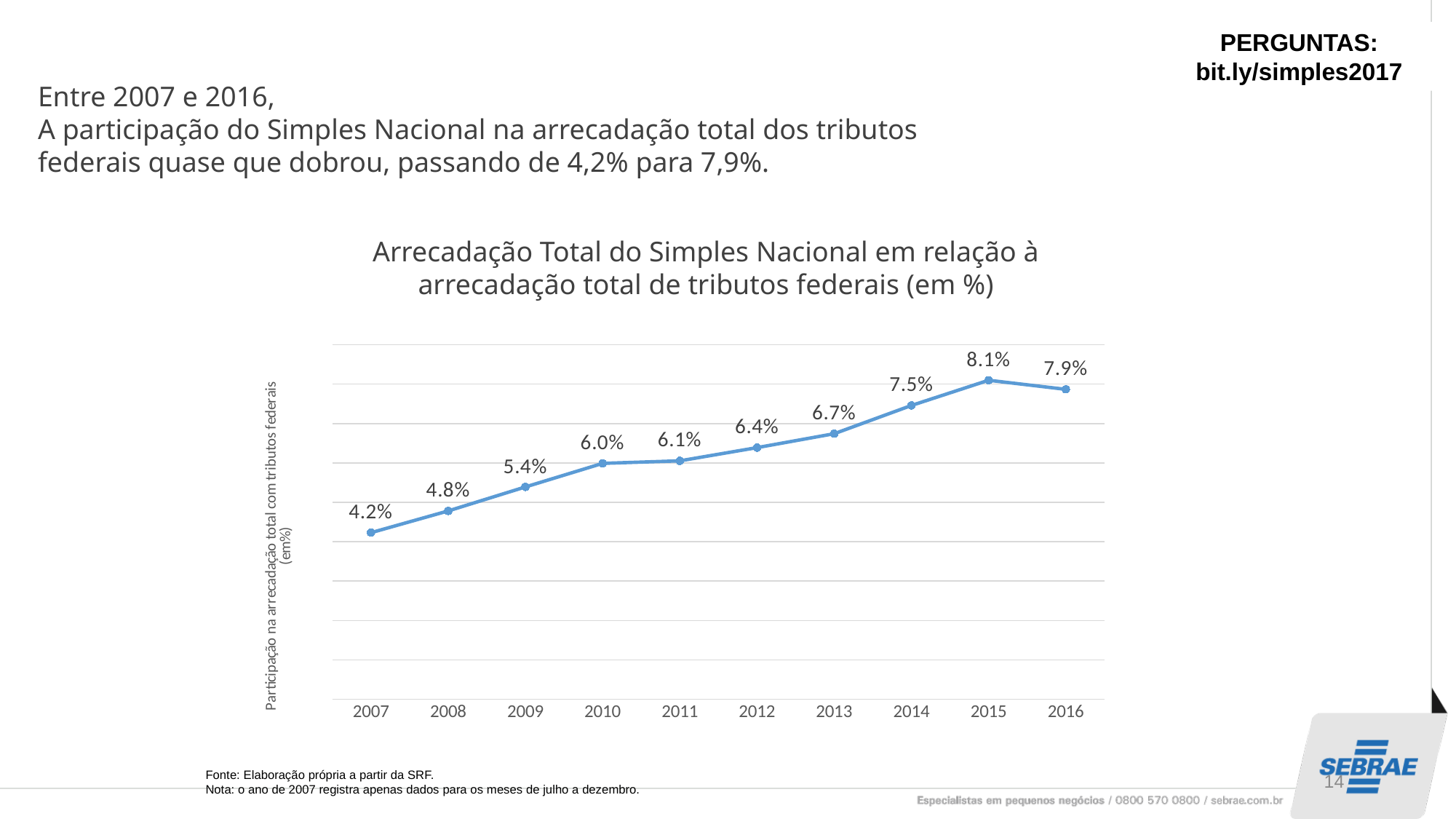
Which is larger, the value for 2010 or the value for 2011? 2011 What is the difference between the values for 2015 and 2007? 3.9% What is the value for 2016? 7.9% Which year has the highest value? 2015 What is the difference between the values for 2016 and 2015? 0.2% What kind of chart is shown? line chart What is the value for 2007? 4.2% Do the values generally rise or fall from 2007 to 2015? rise What is the value for 2012? 6.4% What is the title of the chart? Arrecadação Total do Simples Nacional em relação à arrecadação total de tributos federais (em %) How many years are plotted on the x axis? 10 Which year has the lowest value? 2007